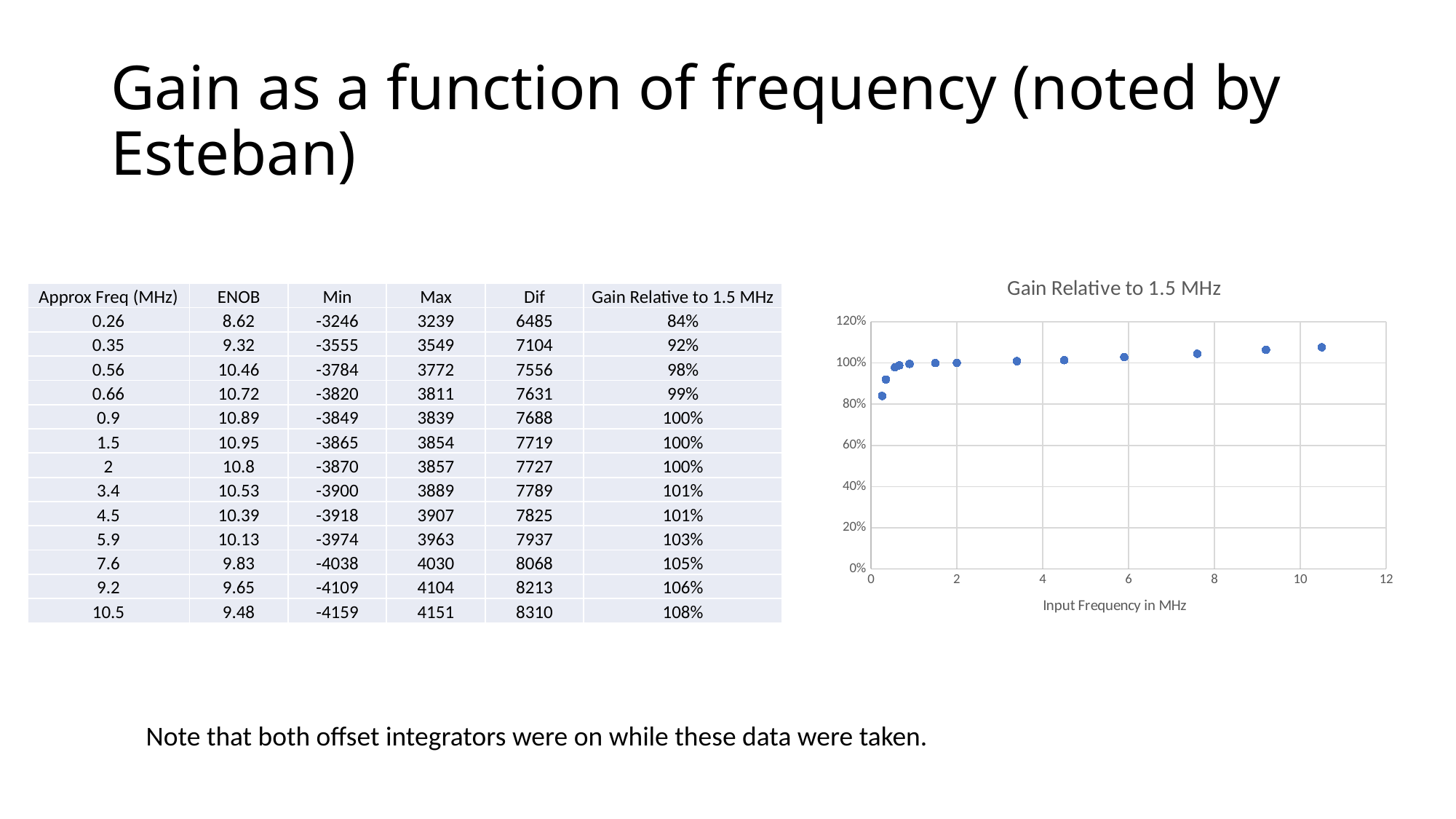
What is the title of the chart? Gain Relative to 1.5 MHz Is the gain value at 10.5 MHz greater or less than 100%? greater According to the table, what is the gain relative to 1.5 MHz at 0.35 MHz? 92% What is the x-axis label of the chart? Input Frequency in MHz Which input frequency has the lowest gain relative to 1.5 MHz? 0.26 MHz Is the gain value at 0.26 MHz greater or less than 80%? greater Is the gain value at 0.26 MHz greater or less than 100%? less What kind of chart is shown on the slide? scatter chart Which input frequency has the highest gain relative to 1.5 MHz? 10.5 MHz Which has the larger gain relative to 1.5 MHz: 0.26 MHz or 9.2 MHz? 9.2 MHz How many data points are plotted in the chart? 13 Do the gain values generally rise or fall as input frequency increases? rise